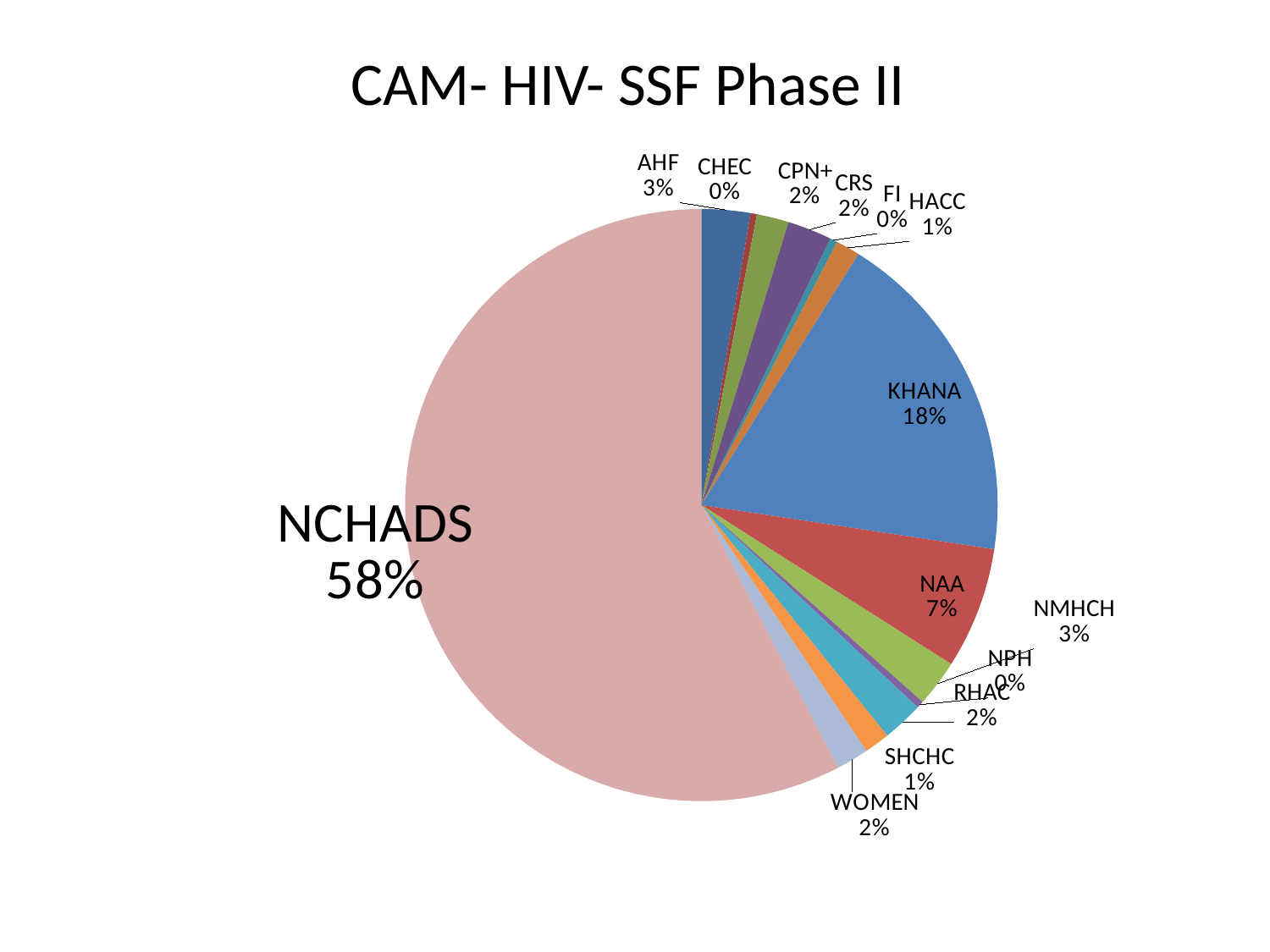
What type of chart is shown on the slide? pie chart What is the title of the chart? CAM- HIV- SSF Phase II Which is larger, the share for KHANA or the share for NAA? KHANA What share of the pie does KHANA hold? 18% What is the value shown for WOMEN? 2% Which category has the largest slice of the pie? NCHADS How many categories are labelled on the pie chart? 14 What share of the pie does NCHADS hold? 58% What is the value shown for AHF? 3% What is the difference between the NCHADS share and the KHANA share? 40% What is the value shown for NAA? 7% What is the value shown for HACC? 1%